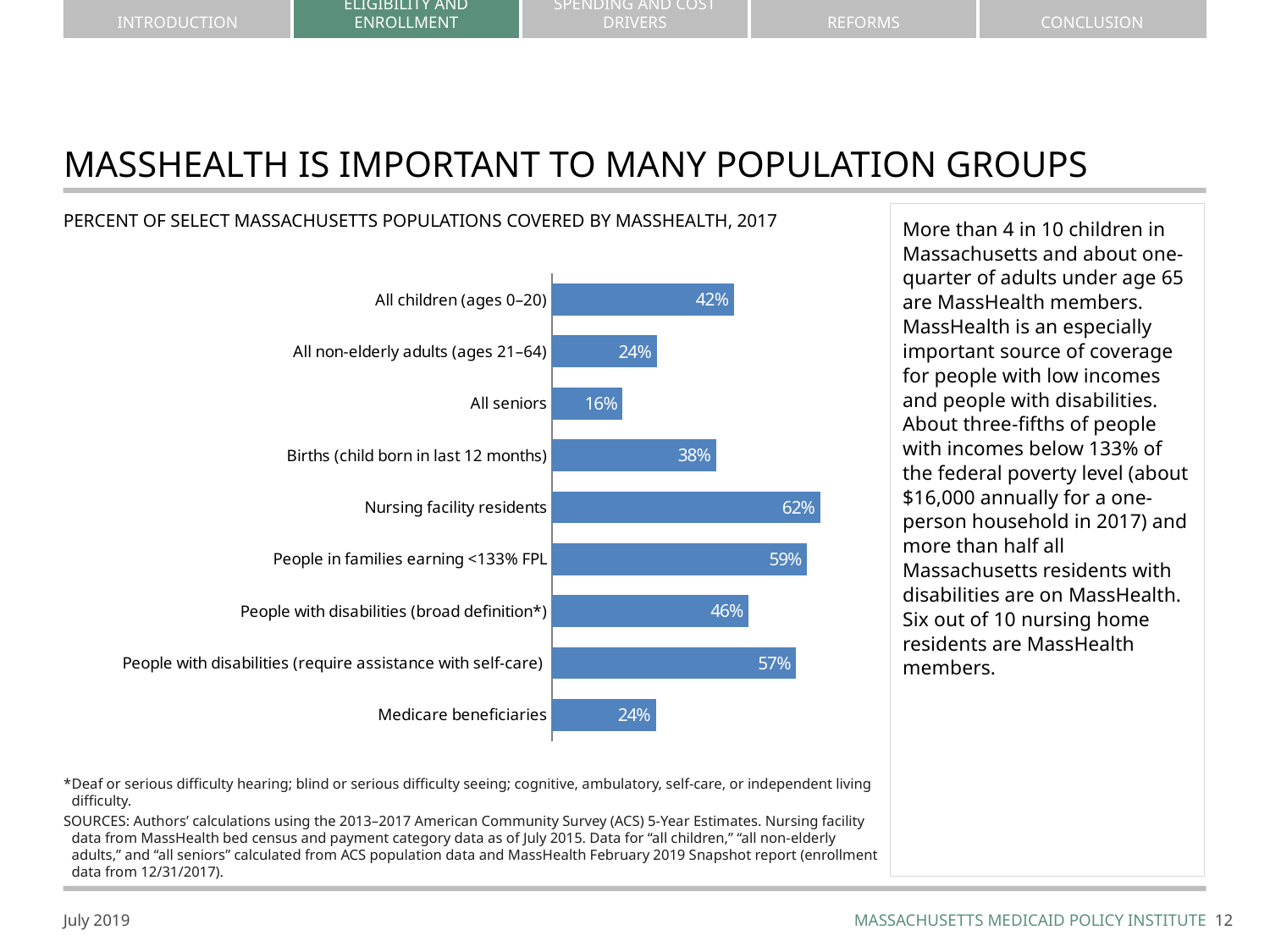
What percent of nursing facility residents are covered by MassHealth? 62% Which population group has the highest percent covered by MassHealth? Nursing facility residents How many population groups are shown in the chart? 9 What percent of all children (ages 0–20) are covered by MassHealth? 42% What is the title of the chart? Percent of select Massachusetts populations covered by MassHealth, 2017 Which population group has the lowest percent covered by MassHealth? All seniors What type of chart is shown on the slide? Bar chart What percent of all seniors are covered by MassHealth? 16% What is the difference between the percent of nursing facility residents and the percent of all seniors covered by MassHealth? 46% Which is larger: the percent covered for births (child born in last 12 months) or for all non-elderly adults (ages 21–64)? Births (child born in last 12 months) What percent of people with disabilities (require assistance with self-care) are covered by MassHealth? 57% What percent of Medicare beneficiaries are covered by MassHealth? 24%